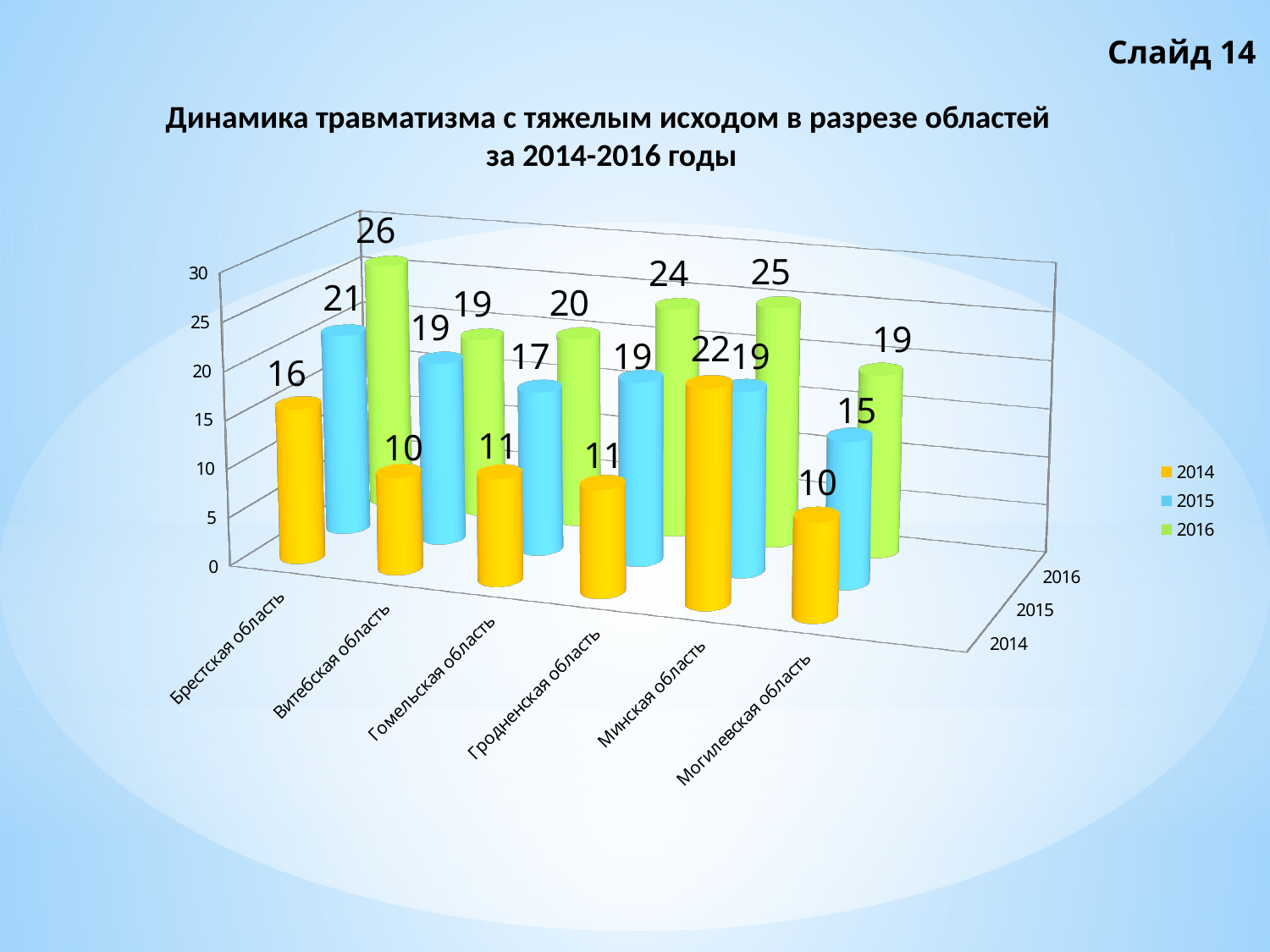
Which region has the lowest value in 2015? Могилевская область What kind of chart is shown on the slide? Bar chart What is the value for Минская область in 2014? 22 Which colour represents the 2016 series in the legend? Green What is the value for Могилевская область in 2015? 15 Which is larger: the 2014 value for Минская область or the 2014 value for Брестская область? Минская область What is the value for Гомельская область in 2015? 17 How many series does the legend list? 3 What is the difference between the 2016 and 2014 values for Брестская область? 10 What is the value for Брестская область in 2016? 26 How many regions are shown on the x axis? 6 Which region has the highest value in 2016? Брестская область